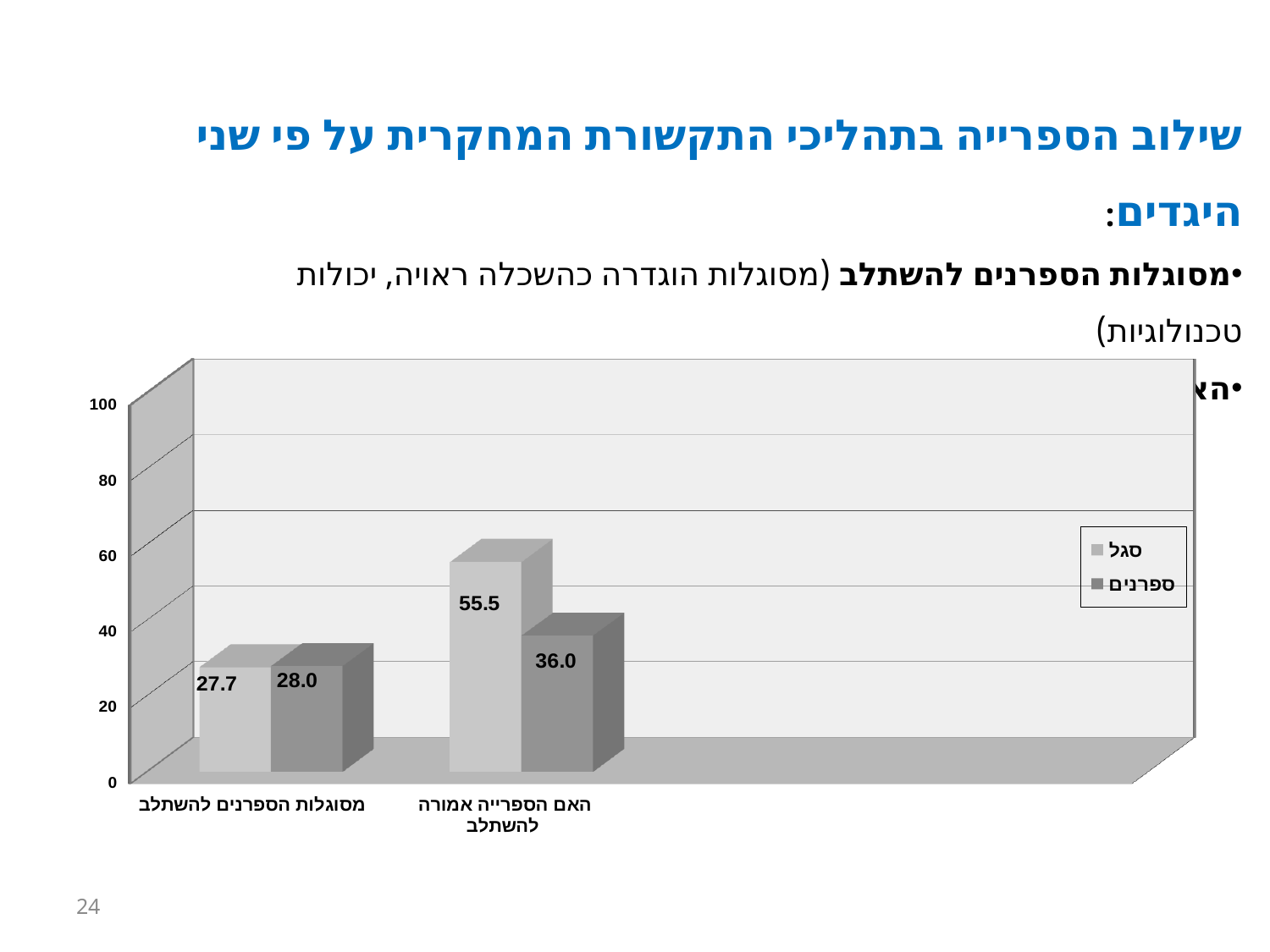
What is the value for סגל in the category מסוגלות הספרנים להשתלב? 27.7 Which bar has the highest value in the chart? סגל, האם הספרייה אמורה להשתלב In the category האם הספרייה אמורה להשתלב, which series has the larger value, סגל or ספרנים? סגל What is the difference between the סגל and ספרנים values in the category האם הספרייה אמורה להשתלב? 19.5 What kind of chart is shown on the slide? bar chart What is the value for ספרנים in the category מסוגלות הספרנים להשתלב? 28.0 What is the value for ספרנים in the category האם הספרייה אמורה להשתלב? 36.0 How many series does the legend list? 2 Which series has the lowest value in the category מסוגלות הספרנים להשתלב? סגל What is the value for סגל in the category האם הספרייה אמורה להשתלב? 55.5 Is the value for סגל in the category האם הספרייה אמורה להשתלב greater or less than 40? greater How many categories are shown on the x axis of the chart? 2